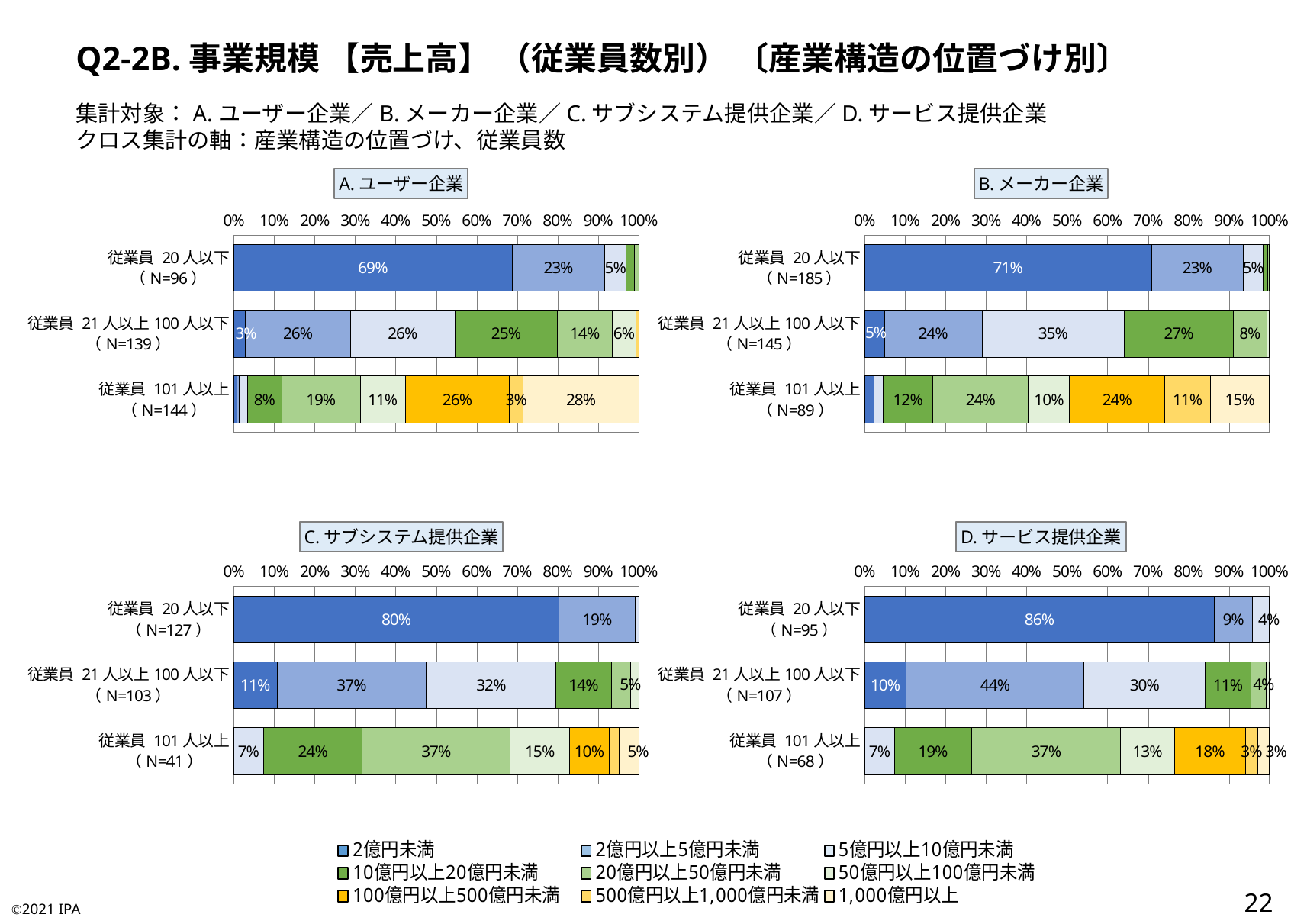
What kind of chart is used on this slide? Stacked bar chart In the D. サービス提供企業 chart, what is the share of 100億円以上500億円未満 for 従業員 101人以上? 18% In the D. サービス提供企業 chart, what is the share of 2億円未満 for 従業員 20人以下? 86% In the C. サブシステム提供企業 chart, what is the share of 20億円以上50億円未満 for 従業員 101人以上? 37% How many employee-size categories does each chart show? 3 In the B. メーカー企業 chart, which is larger for 従業員 101人以上: the 10億円以上20億円未満 share or the 20億円以上50億円未満 share? 20億円以上50億円未満 How many revenue bands does the legend list? 9 In the B. メーカー企業 chart, what is the share of 5億円以上10億円未満 for 従業員 21人以上100人以下? 35% What is the sample size (N) for 従業員 101人以上 in the C. サブシステム提供企業 chart? 41 Which chart shows the larger 2億円未満 share for 従業員 20人以下: C. サブシステム提供企業 or D. サービス提供企業? D. サービス提供企業 In the A. ユーザー企業 chart, what is the share of 2億円未満 for 従業員 20人以下? 69% In the A. ユーザー企業 chart, what is the difference between the 1,000億円以上 share and the 100億円以上500億円未満 share for 従業員 101人以上? 2%